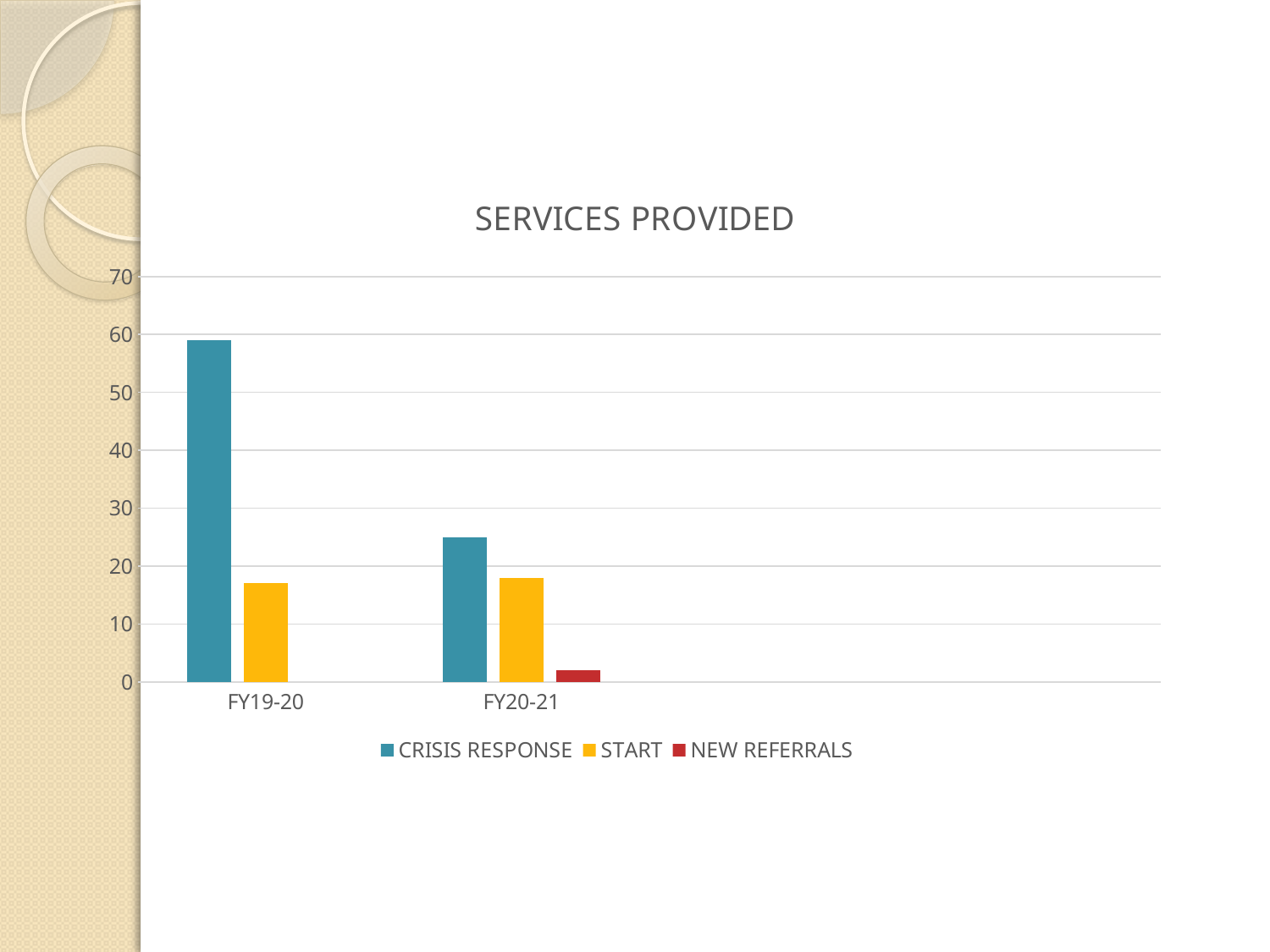
Which colour represents the START series in the legend? Yellow How many series does the legend list? 3 Which series has the lowest value in FY20-21? NEW REFERRALS How many fiscal year categories are shown on the x axis? 2 What is the title of the chart? SERVICES PROVIDED Does the CRISIS RESPONSE value rise or fall from FY19-20 to FY20-21? Fall Which is larger: CRISIS RESPONSE in FY19-20 or CRISIS RESPONSE in FY20-21? FY19-20 What kind of chart is shown on the slide? Bar chart Is the CRISIS RESPONSE value for FY19-20 greater or less than 50? greater Which series has the highest value in FY19-20? CRISIS RESPONSE Is the START value for FY19-20 greater or less than 20? less Is the NEW REFERRALS value for FY20-21 greater or less than 10? less